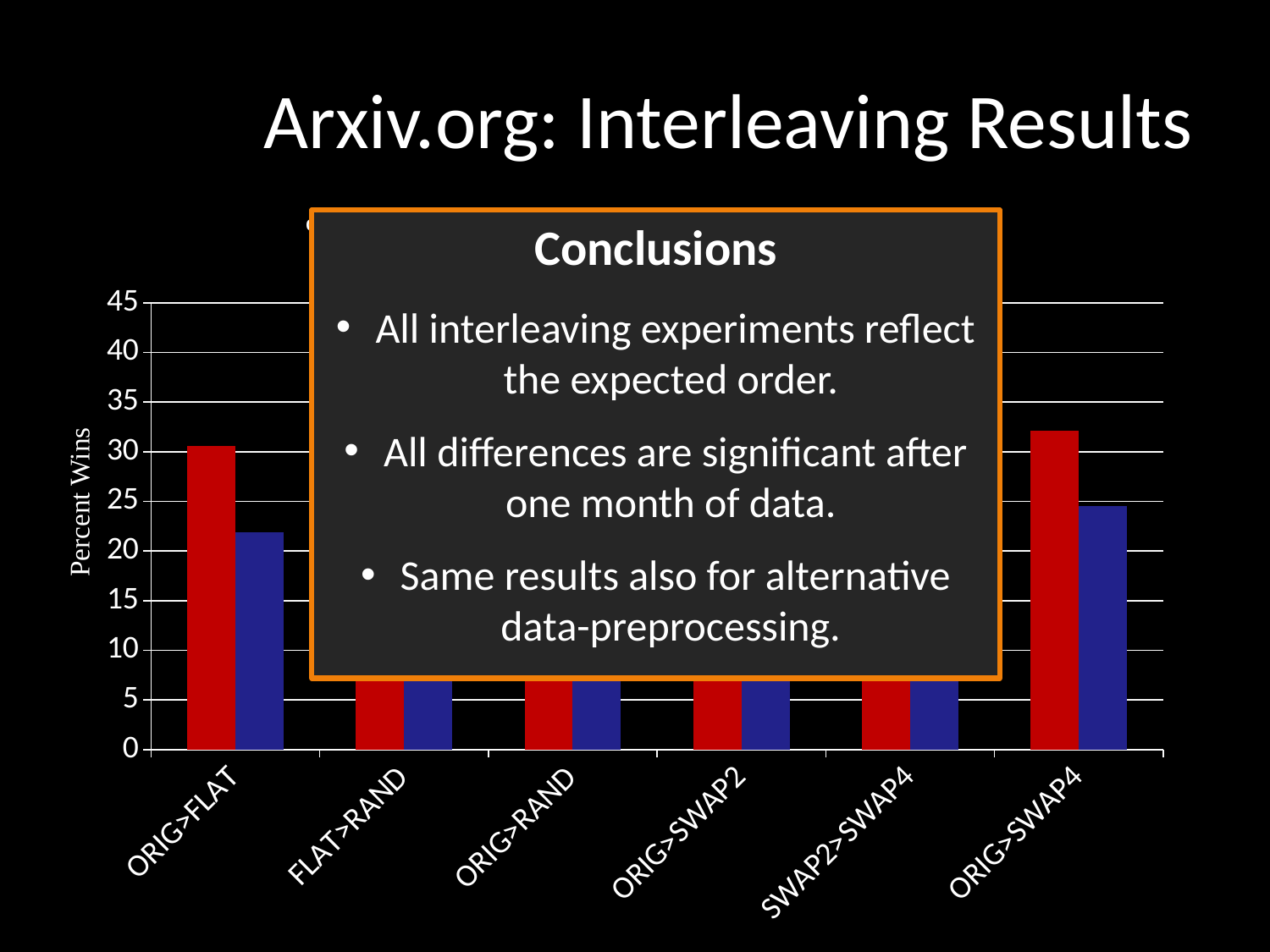
Is the value of the red bar for ORIG>SWAP4 greater or less than 25? greater What is the highest tick value shown on the y axis of the chart? 45 What is the label of the y axis of the chart? Percent Wins How many categories are shown on the x axis of the chart? 6 Is the value of the red bar for ORIG>FLAT greater or less than 25? greater Is the value of the blue bar for ORIG>SWAP4 greater or less than 30? less For ORIG>SWAP4, which bar is taller, the red bar or the blue bar? the red bar Which has the taller blue bar, ORIG>FLAT or ORIG>SWAP4? ORIG>SWAP4 What kind of chart is shown on the slide? bar chart For ORIG>FLAT, which bar is taller, the red bar or the blue bar? the red bar